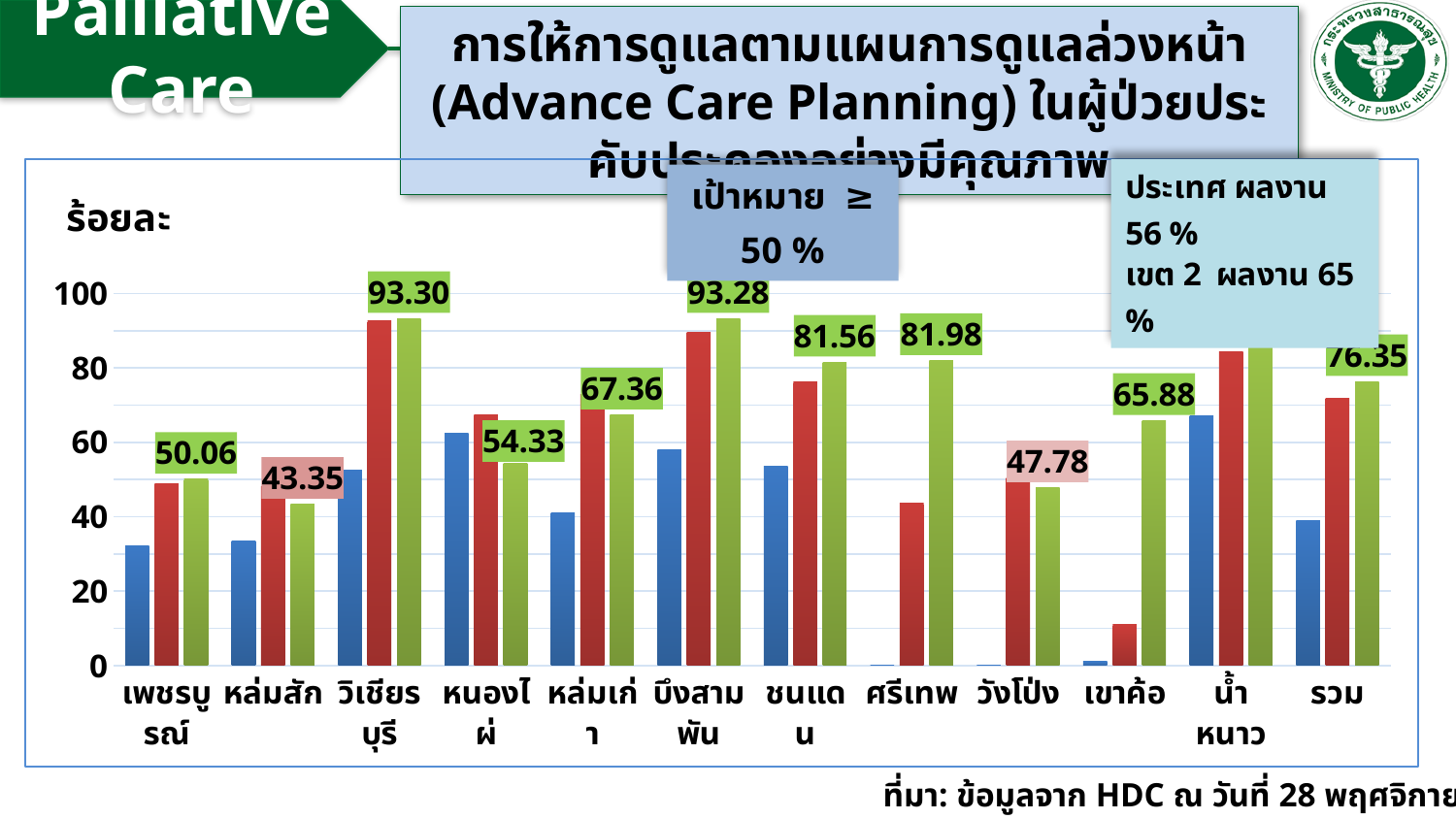
What target value is stated in the box above the chart? ≥ 50 % What type of chart is shown on the slide? bar chart Is the value of the blue bar for เพชรบูรณ์ greater or less than 40? less How many bars are plotted for each category in the chart? 3 Is the value of the red bar for เขาค้อ greater or less than 20? less Which category has the lowest labelled value? หล่มสัก What is the labelled value for หล่มสัก? 43.35 What is the difference between the labelled values for วิเชียรบุรี and หล่มสัก? 49.95 What is the labelled value for รวม? 76.35 Which has the larger labelled value, ศรีเทพ or ชนแดน? ศรีเทพ What is the labelled value for วิเชียรบุรี? 93.30 How many categories are shown along the x axis of the chart? 12